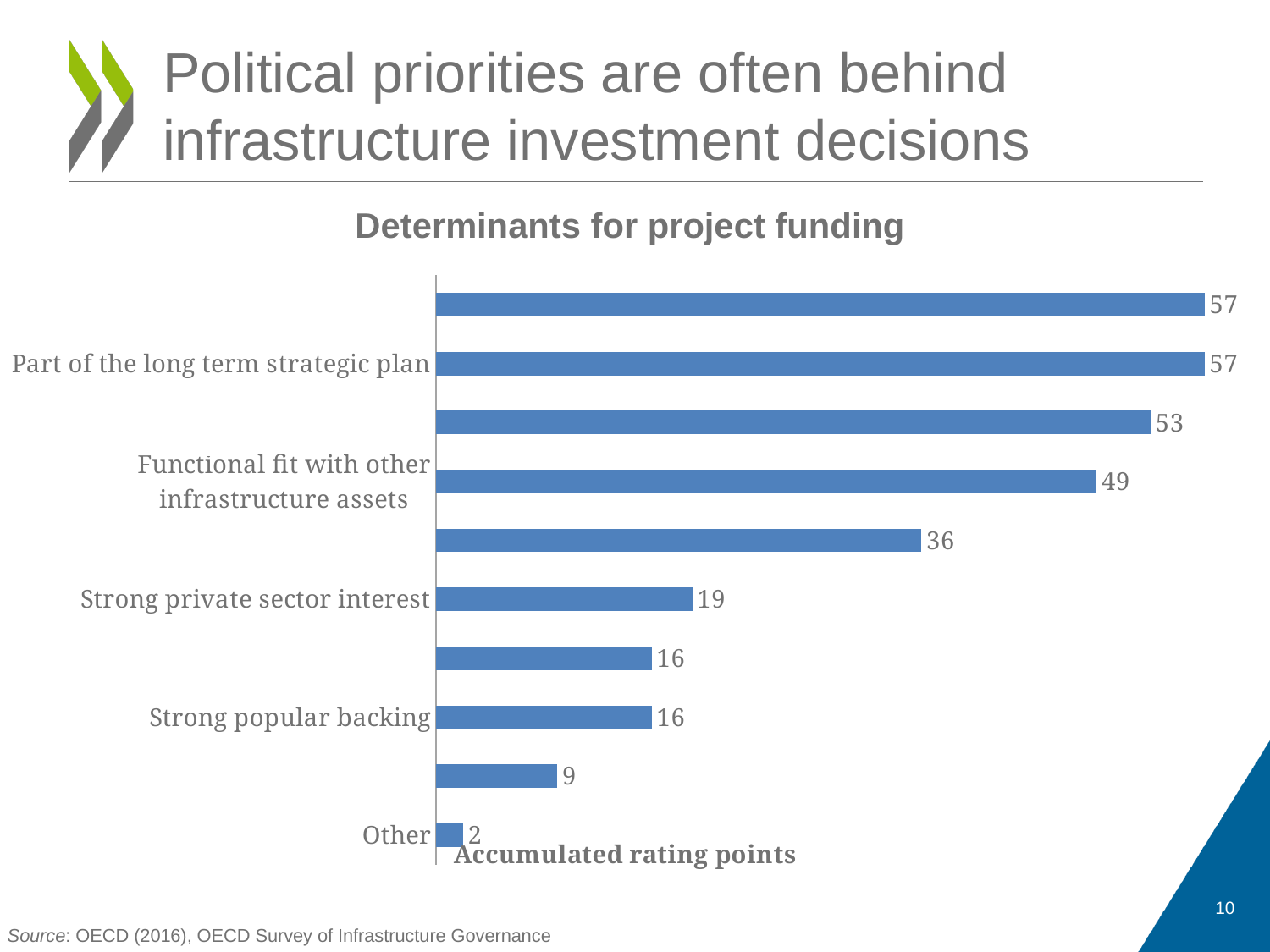
How many bars are plotted in the chart? 10 What is the value for 'Other'? 2 What is the value for 'Strong private sector interest'? 19 Which is larger, 'Strong private sector interest' or 'Strong popular backing'? Strong private sector interest What is the value for 'Part of the long term strategic plan'? 57 What is the difference between 'Strong private sector interest' and 'Strong popular backing'? 3 What kind of chart is shown on the slide? Bar chart What is the value for 'Strong popular backing'? 16 What is the title of the chart? Determinants for project funding What is the difference between 'Part of the long term strategic plan' and 'Functional fit with other infrastructure assets'? 8 Which category has the lowest value? Other What is the value for 'Functional fit with other infrastructure assets'? 49